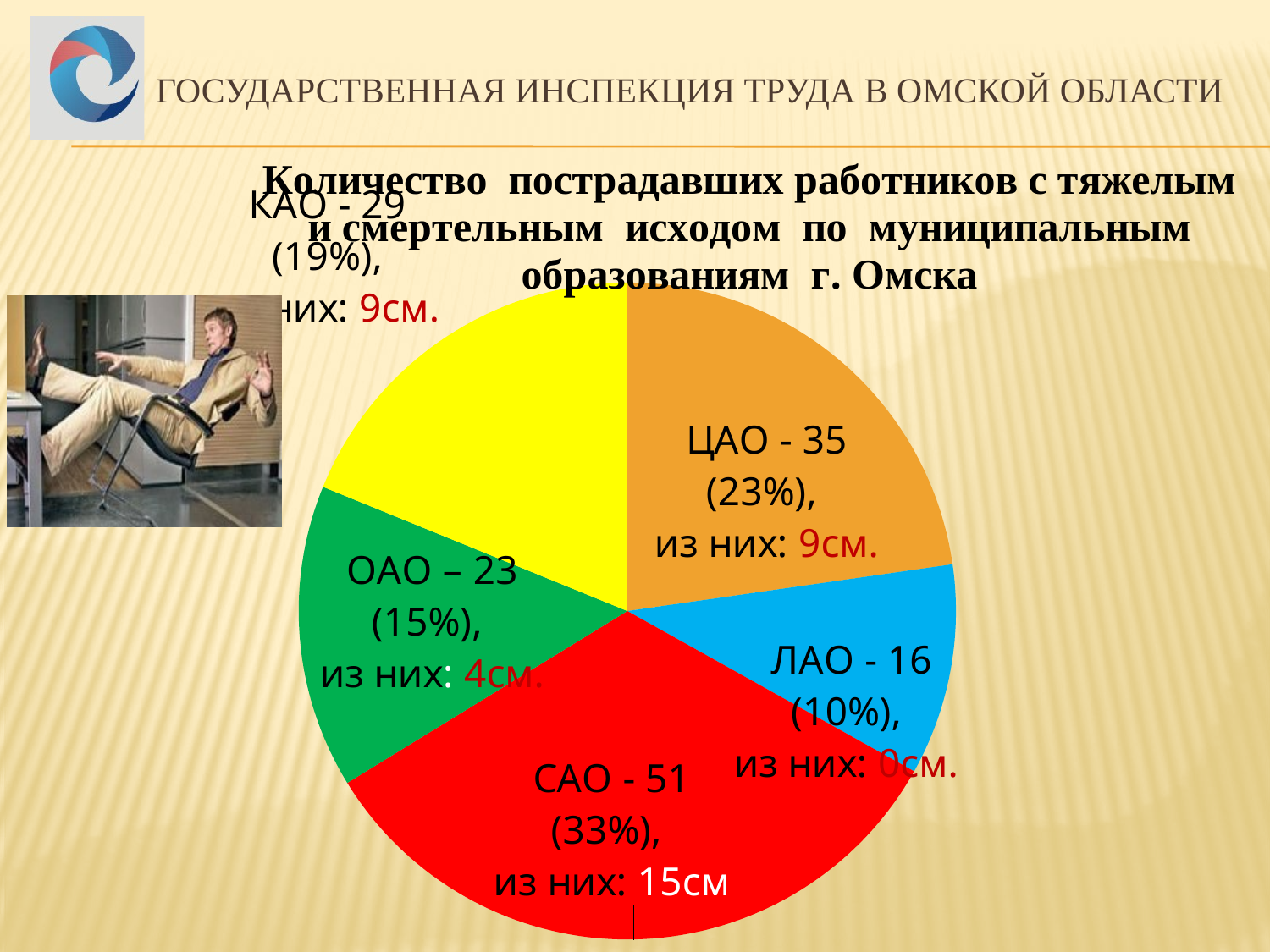
What is the value shown for ЛАО in the pie chart? 16 How many slices does the pie chart have? 5 What percentage share does ОАО have in the pie chart? 15% Which district has the largest slice in the pie chart? САО What percentage share does САО have in the pie chart? 33% What colour is the slice for САО in the pie chart? red What is the difference between the values for САО and ЦАО? 16 What kind of chart is shown on the slide? pie chart What is the value shown for САО in the pie chart? 51 What is the value shown for ЦАО in the pie chart? 35 Which district has the smallest slice in the pie chart? ЛАО Which is larger, the value for ЦАО or the value for ОАО? ЦАО